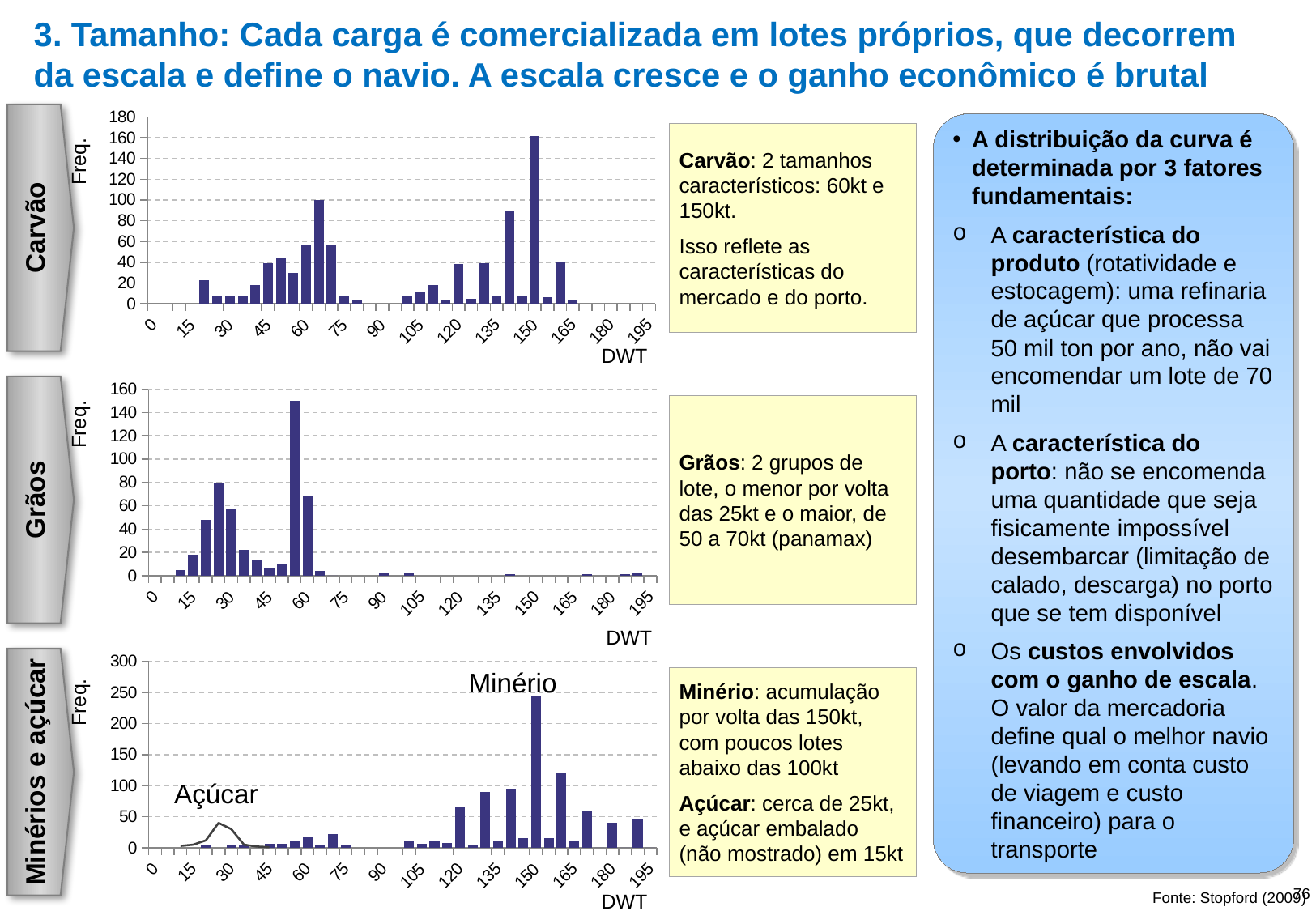
In the Grãos chart, are the bars above 90 DWT greater or less than 20? less In the Carvão chart, are the bars between 90 and 105 DWT greater or less than 20? less In the Minérios e açúcar chart, which reaches a higher frequency: the Minério bars or the Açúcar curve? Minério In the Minérios e açúcar chart, are the bars between 45 and 90 DWT greater or less than 50? less Which of the three charts has the highest maximum value on its vertical axis? Minérios e açúcar What is the label of the horizontal axis on the Carvão chart? DWT How many charts are shown on the slide? 3 What kind of chart is the Carvão chart at the top of the slide? bar chart